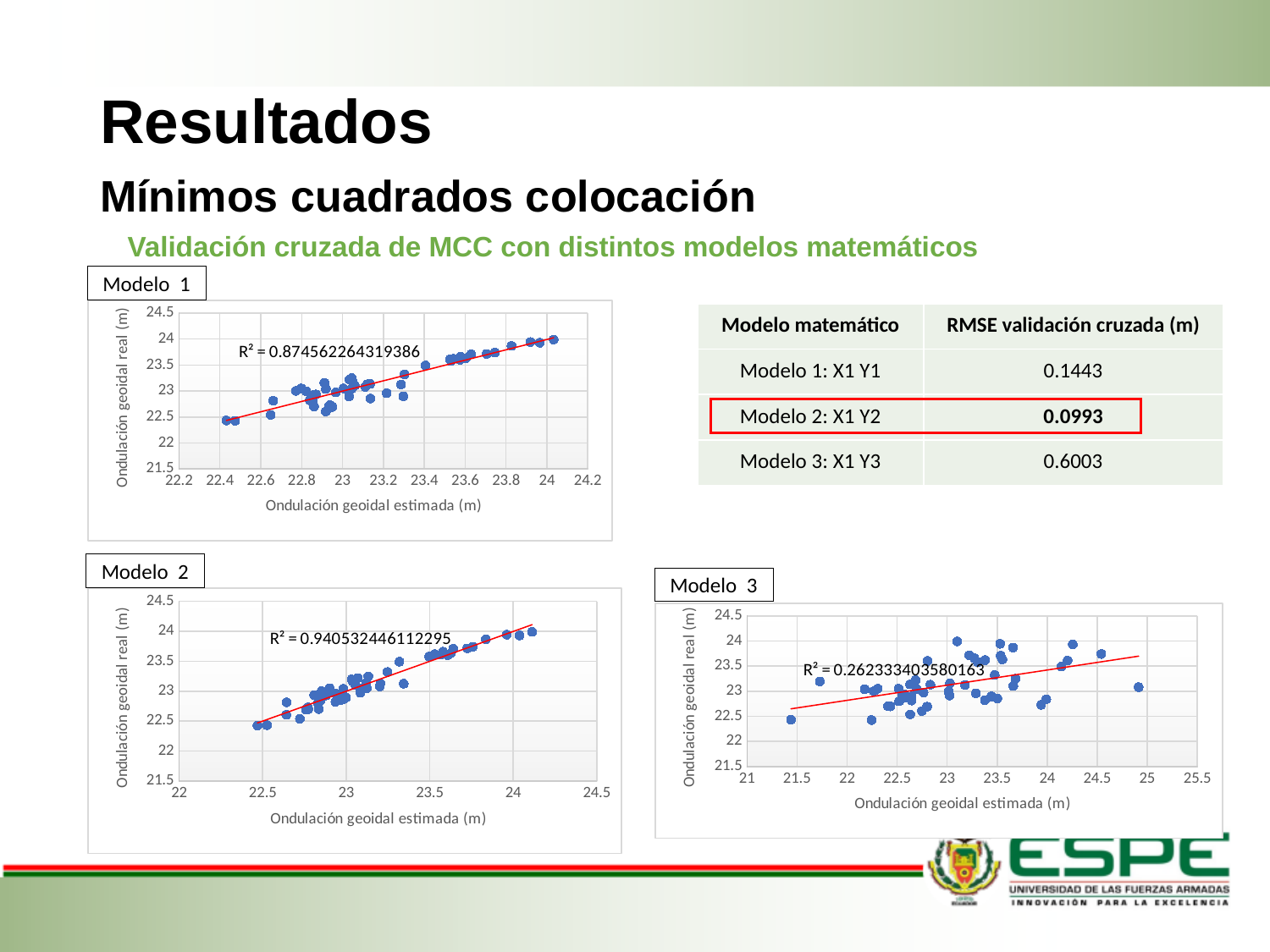
What is the x-axis title of the Modelo 2 chart? Ondulación geoidal estimada (m) Which chart has the larger R² value, Modelo 1 or Modelo 3? Modelo 1 What is the y-axis title of the Modelo 3 chart? Ondulación geoidal real (m) Which of the three charts shows the lowest R² value? Modelo 3 What kind of chart is the Modelo 1 chart? scatter chart How many scatter charts are shown on the slide? 3 In the Modelo 1 chart, what R² value is printed? R² = 0.874562264319386 Which of the three charts shows the highest R² value? Modelo 2 In the Modelo 3 chart, does the fitted trend line rise or fall from left to right? rise In the Modelo 2 chart, what R² value is printed? R² = 0.940532446112295 In the Modelo 2 chart, do the plotted values generally rise or fall as the x-axis value increases? rise In the Modelo 3 chart, what R² value is printed? R² = 0.262333403580163